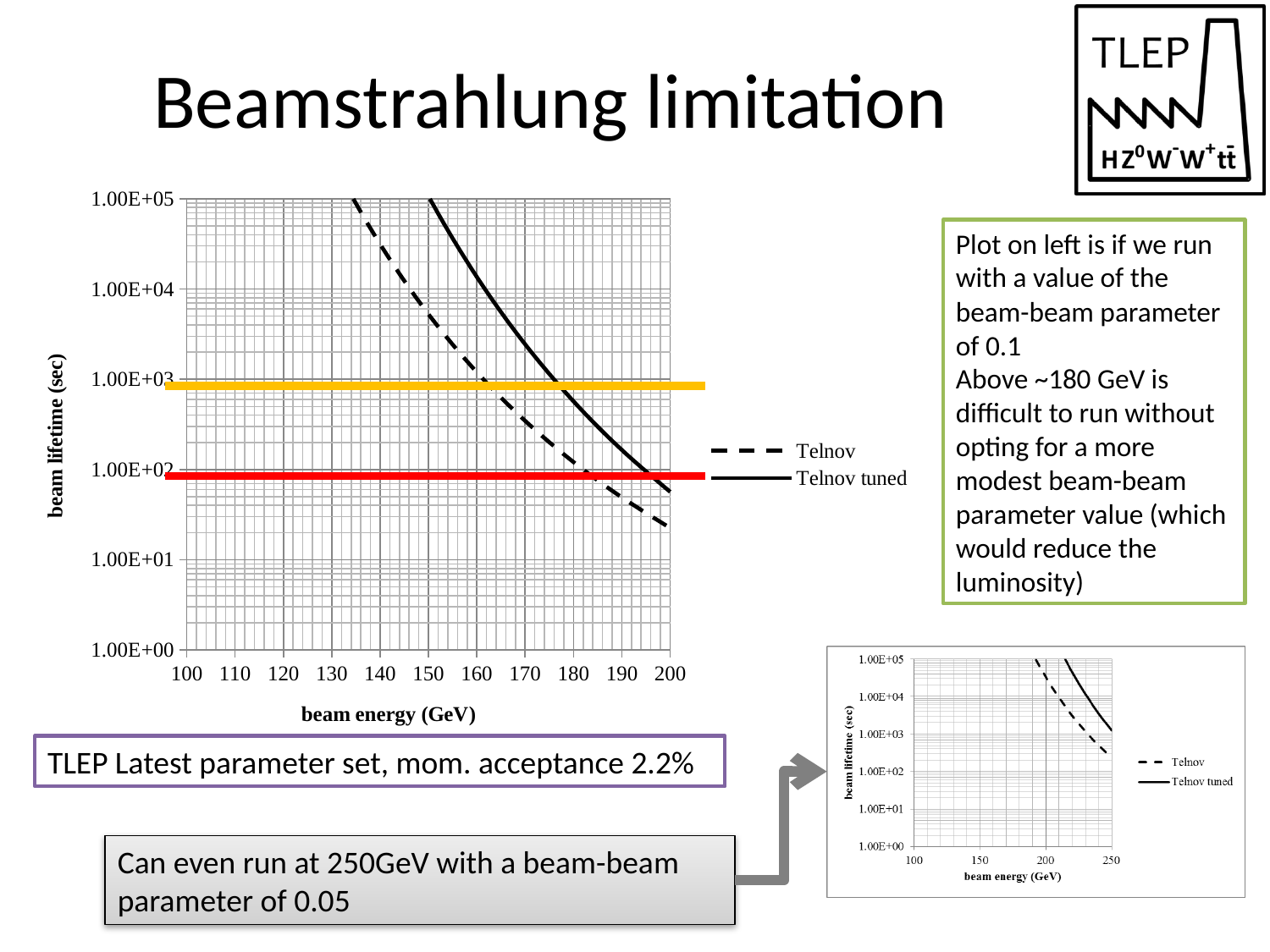
What is the x-axis title of the large chart on the left? beam energy (GeV) In the large chart on the left, does the beam lifetime for the Telnov series rise or fall as beam energy increases? fall How many series does the legend of the large chart on the left list? 2 In the large chart on the left, is the beam lifetime for Telnov at 200 GeV greater or less than 1.00E+02 sec? less In the large chart on the left, is the beam lifetime for Telnov tuned at 200 GeV greater or less than 1.00E+02 sec? less What is the highest beam energy value shown on the x axis of the small chart at the bottom right? 250 In the large chart on the left, which series is drawn with a dashed line? Telnov What kind of chart is the large chart on the left of the slide? line chart In the large chart on the left, is the beam lifetime for Telnov at 150 GeV greater or less than 1.00E+03 sec? greater In the large chart on the left, at a beam energy of 180 GeV, which series has the larger beam lifetime, Telnov or Telnov tuned? Telnov tuned In the large chart on the left, does the beam lifetime for the Telnov tuned series rise or fall as beam energy increases? fall